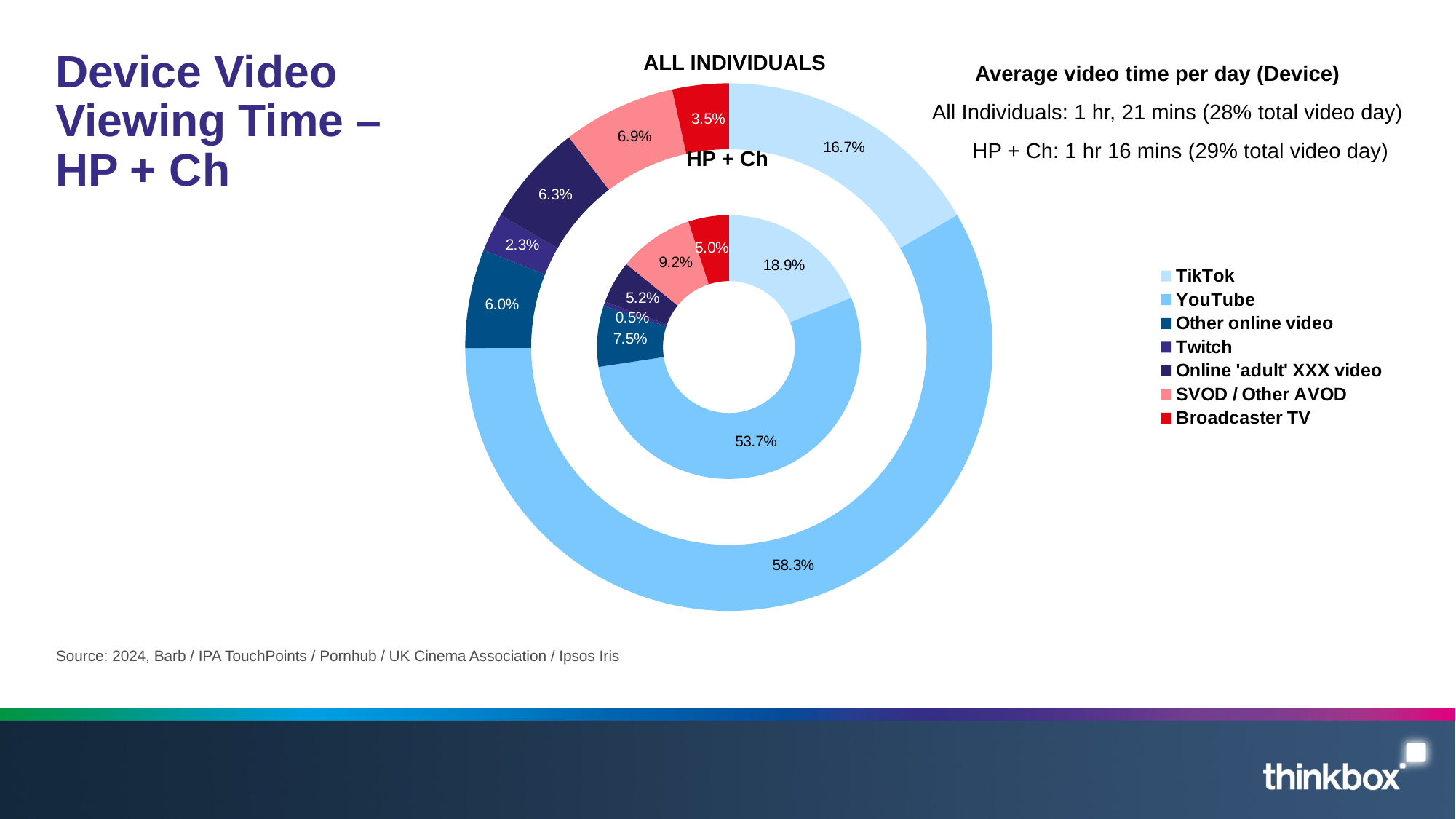
In the HP + Ch ring, what share of device video viewing time is YouTube? 53.7% Which category has the largest share in the ALL INDIVIDUALS ring? YouTube Which category has the smallest share in the HP + Ch ring? Twitch In the ALL INDIVIDUALS ring, what is the value for TikTok? 16.7% What is the difference between the TikTok share for HP + Ch and the TikTok share for ALL INDIVIDUALS? 2.2% How many series does the legend list? 7 What kind of chart is shown on the slide? Doughnut chart According to the text on the slide, what is the average device video time per day for All Individuals? 1 hr, 21 mins Which is larger: the SVOD / Other AVOD share for ALL INDIVIDUALS or for HP + Ch? HP + Ch In the HP + Ch ring, what is the value for Broadcaster TV? 5.0% In the ALL INDIVIDUALS ring, what share of device video viewing time is YouTube? 58.3% In the HP + Ch ring, what is the value for Twitch? 0.5%